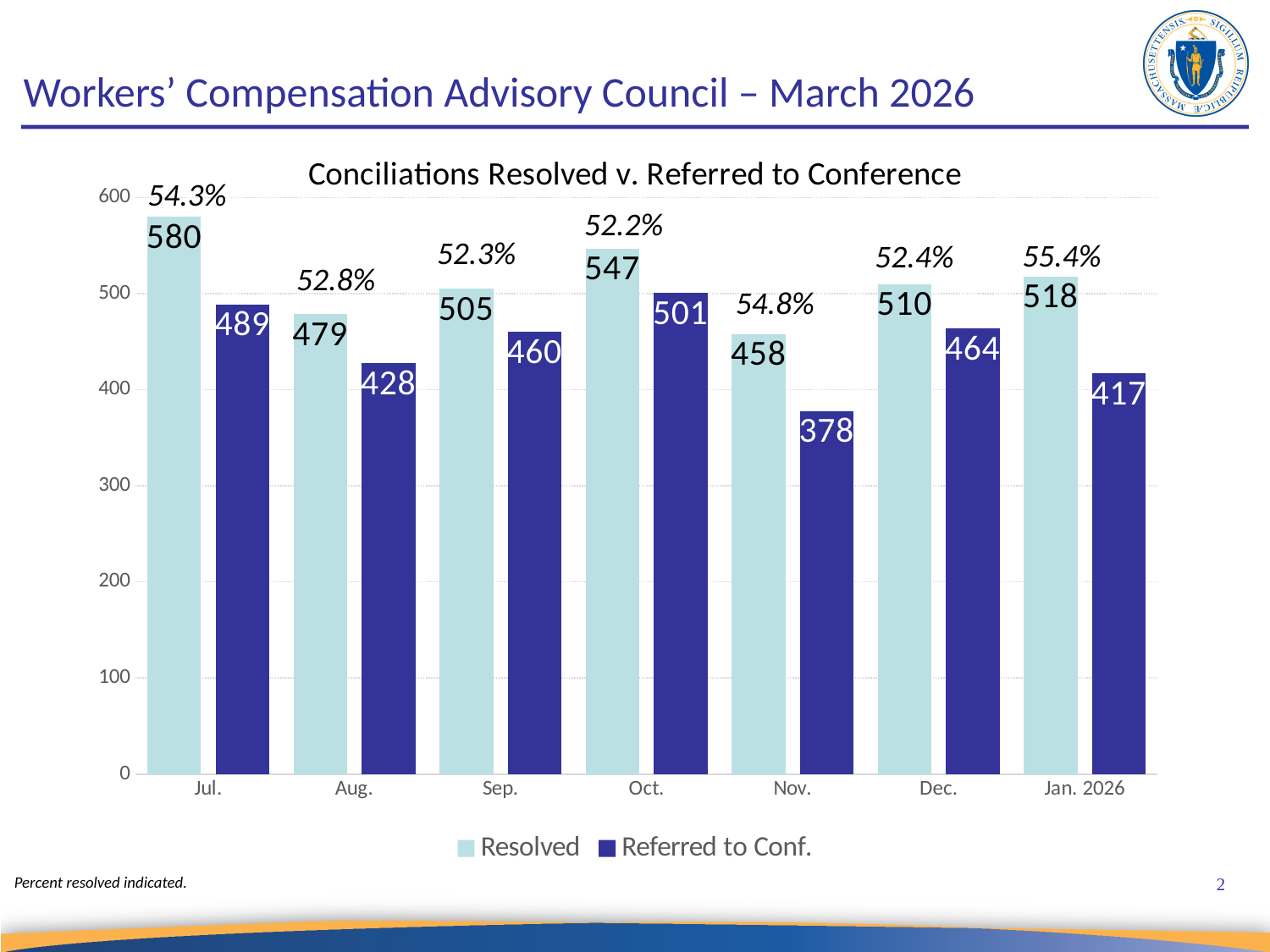
What kind of chart is shown? Bar chart Which is larger, the Referred to Conf. value for Aug. or for Dec.? Dec. What is the difference between the Resolved and Referred to Conf. values for Oct.? 46 How many series does the legend list? 2 How many months are shown on the x axis? 7 What is the Resolved value for Jul.? 580 What is the title of the chart? Conciliations Resolved v. Referred to Conference Which series is shown in dark blue? Referred to Conf. What percent resolved is indicated for Jan. 2026? 55.4% Which month has the lowest Referred to Conf. value? Nov. What is the Referred to Conf. value for Nov.? 378 Which month has the highest Resolved value? Jul.